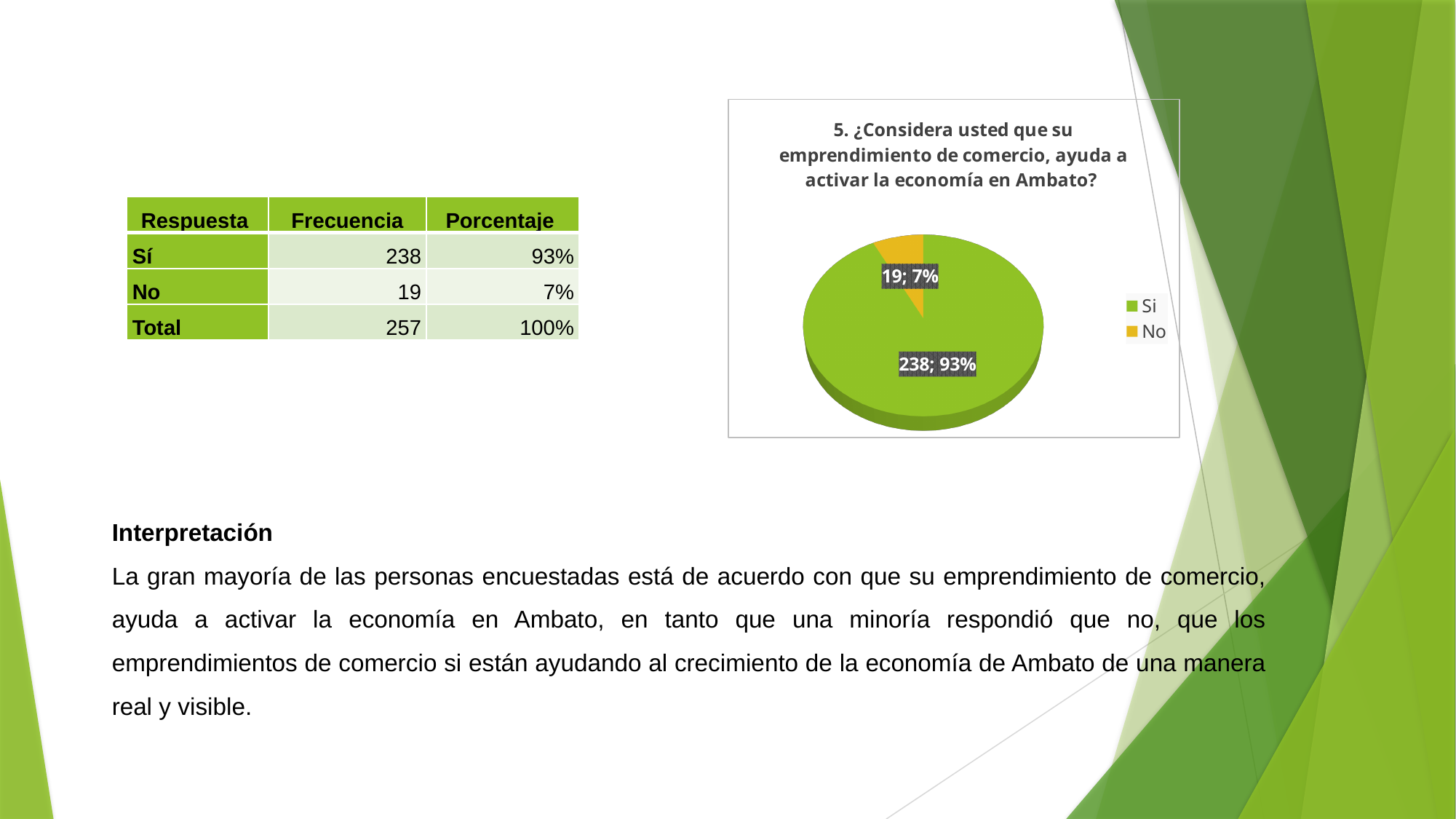
What percentage does the 'Si' slice represent in the pie chart? 93% Which category has the smallest slice in the pie chart? No Which category has the largest slice in the pie chart? Si What is the difference in frequency between the 'Si' and 'No' slices? 219 How many slices does the pie chart have? 2 What kind of chart is shown on the slide? Pie chart What is the frequency value shown for the 'Si' slice in the pie chart? 238 What is the frequency value shown for the 'No' slice in the pie chart? 19 Which is larger in the pie chart, the 'Si' slice or the 'No' slice? Si What percentage does the 'No' slice represent in the pie chart? 7% What colour is the 'No' slice in the pie chart? Yellow/orange How many entries does the legend of the pie chart list? 2